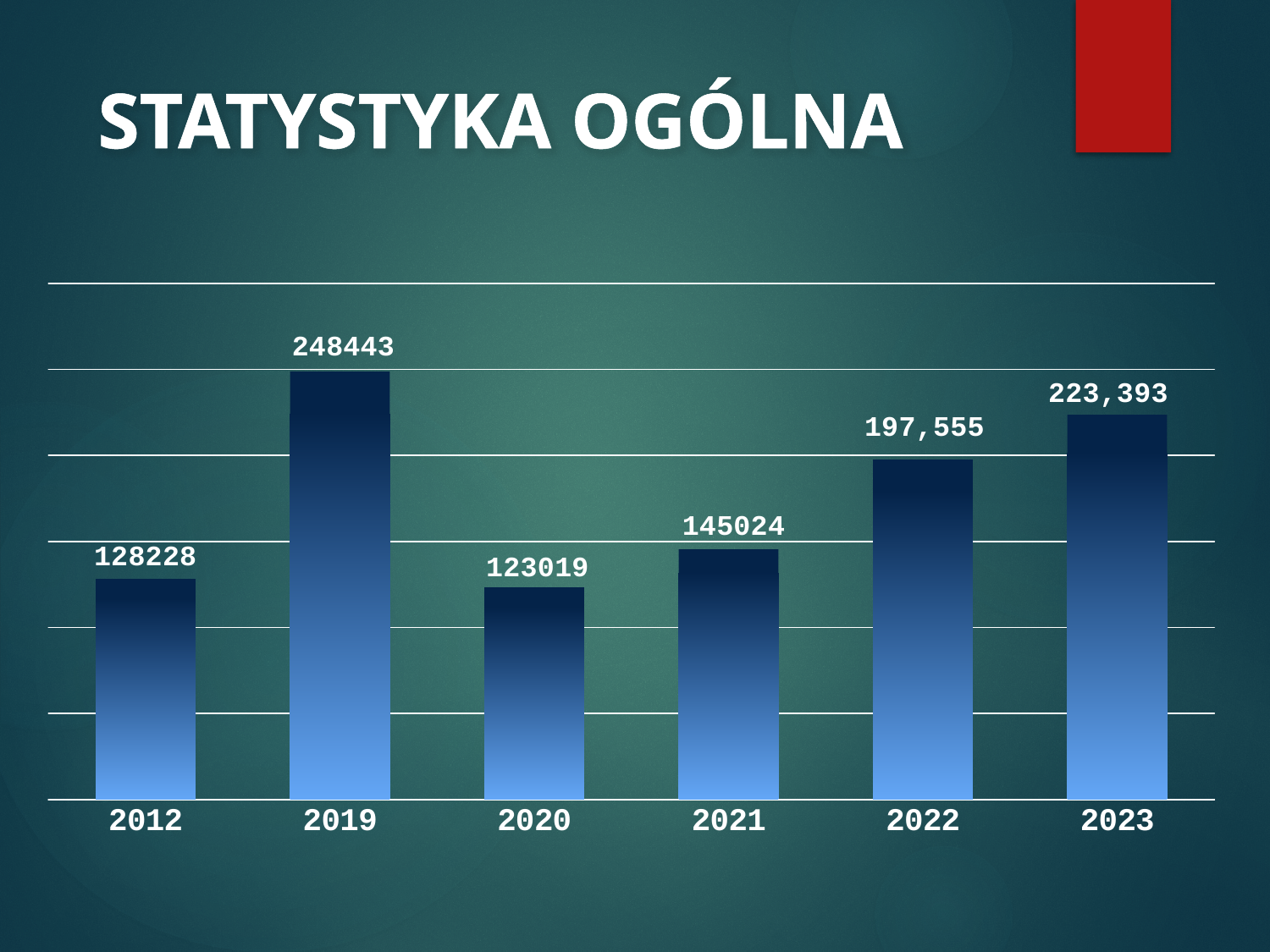
Which year has the lowest value? 2020 What is the difference between the values for 2019 and 2023? 25050 What is the value for 2022? 197,555 What is the value for 2019? 248443 From 2020 to 2023, do the values rise or fall? rise Which is larger, the value for 2021 or the value for 2012? 2021 How many years are shown on the x axis? 6 What kind of chart is shown on the slide? bar chart What is the value for 2012? 128228 Which year has the highest value? 2019 What is the difference between the values for 2022 and 2021? 52531 What is the value for 2023? 223,393